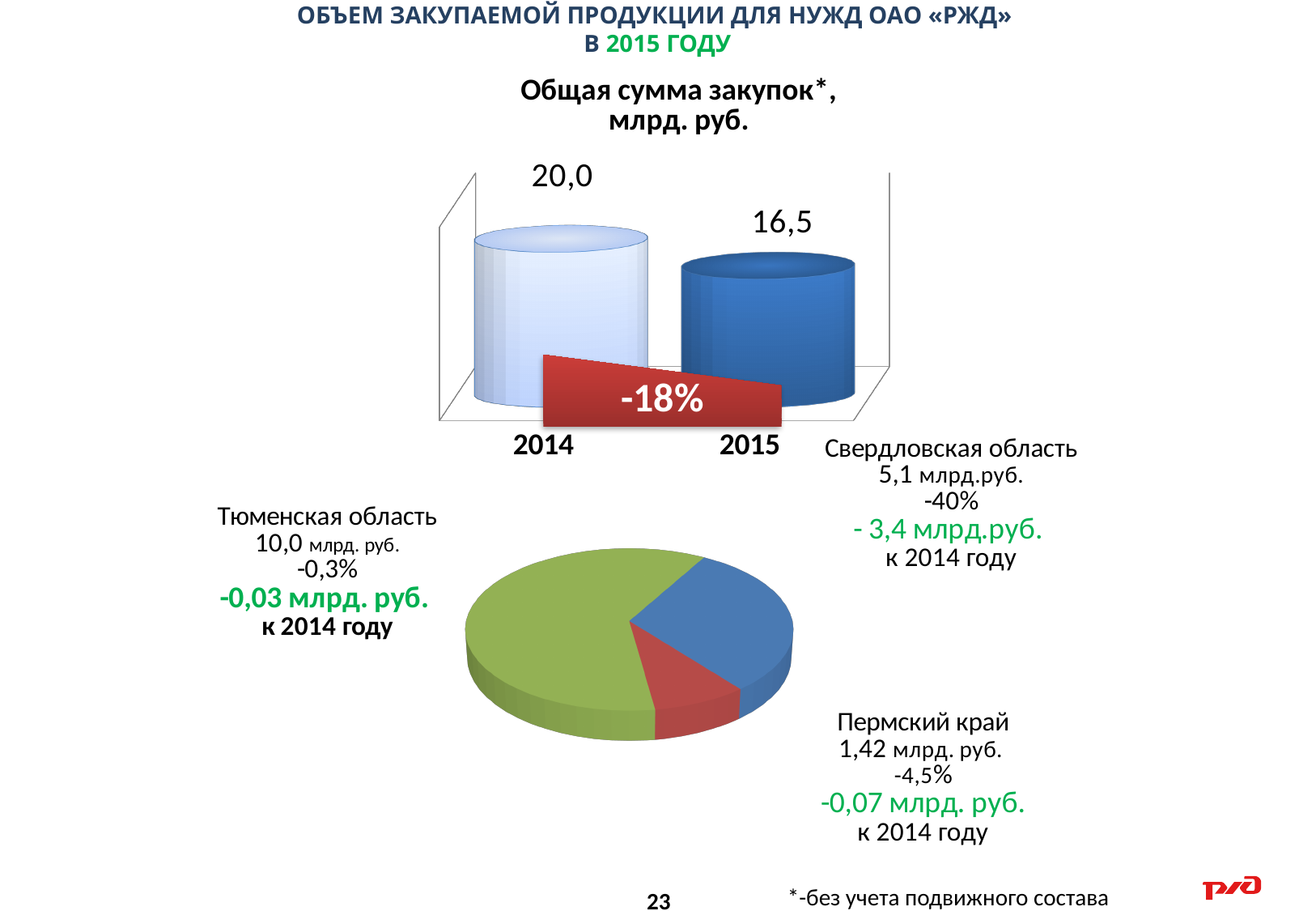
In the bar chart 'Общая сумма закупок*, млрд. руб.', which year has the higher value, 2014 or 2015? 2014 What kind of chart is the bottom chart on the slide? pie chart How many categories are shown in the bar chart 'Общая сумма закупок*, млрд. руб.'? 2 In the bar chart 'Общая сумма закупок*, млрд. руб.', what is the value for 2014? 20,0 In the bar chart 'Общая сумма закупок*, млрд. руб.', what percentage change is shown on the red arrow between 2014 and 2015? -18% In the bar chart 'Общая сумма закупок*, млрд. руб.', what is the difference between the 2014 and 2015 values? 3,5 What kind of chart is the top chart 'Общая сумма закупок*, млрд. руб.'? bar chart In the pie chart at the bottom of the slide, what is the value for Свердловская область? 5,1 млрд.руб. In the bar chart 'Общая сумма закупок*, млрд. руб.', what is the value for 2015? 16,5 In the bar chart 'Общая сумма закупок*, млрд. руб.', do the values rise or fall from 2014 to 2015? fall In the pie chart at the bottom of the slide, which region has the largest value? Тюменская область How many slices does the pie chart at the bottom of the slide have? 3